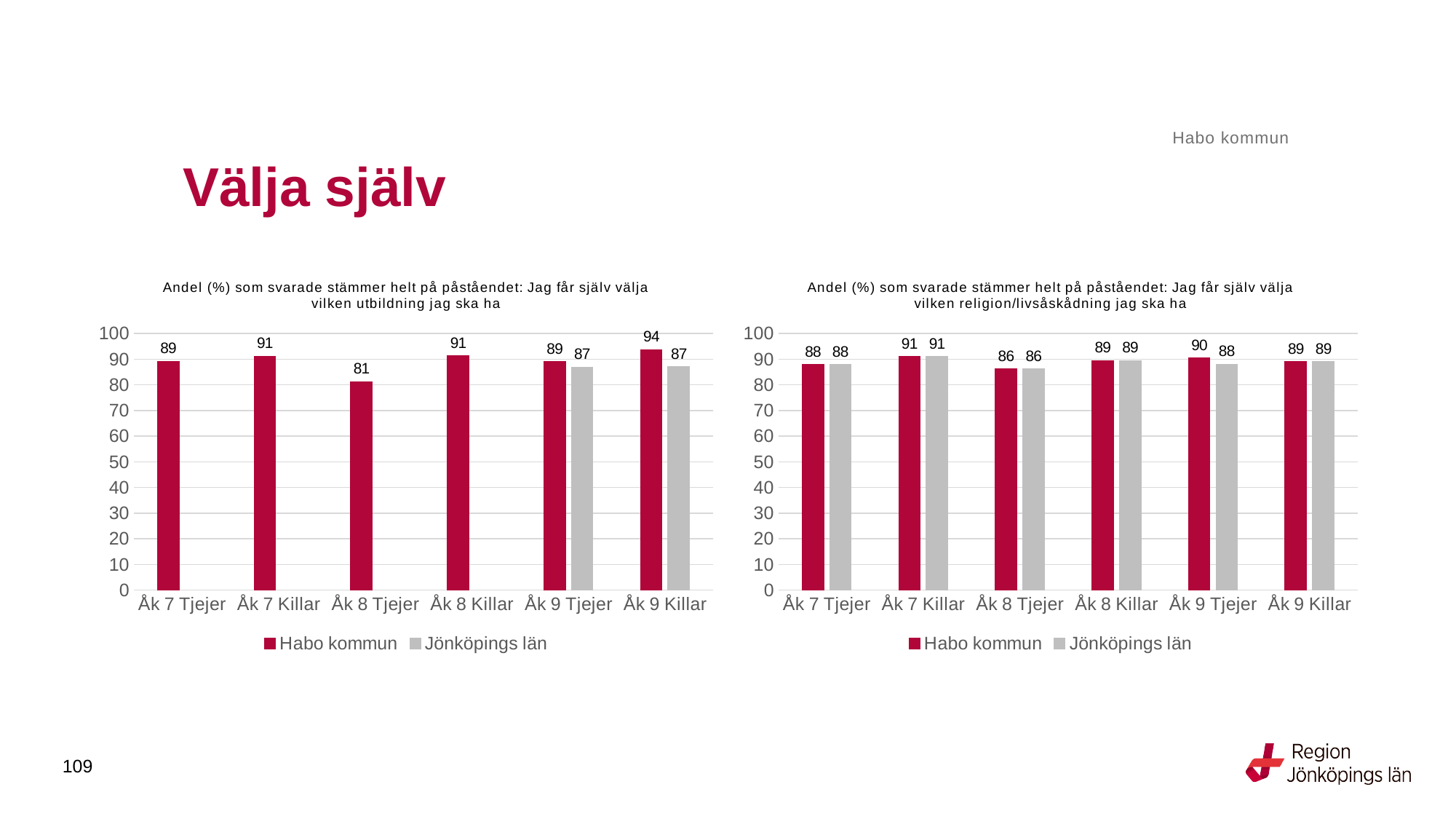
In the right chart (about choosing religion), what is the value for Habo kommun for Åk 9 Tjejer? 90 In the right chart (about choosing religion), which category has the highest Habo kommun value? Åk 7 Killar In the left chart (about choosing education), what is the difference between the Habo kommun values for Åk 9 Killar and Åk 8 Tjejer? 13 In the left chart (about choosing education), which category has the lowest Habo kommun value? Åk 8 Tjejer In the right chart (about choosing religion), what is the value for Jönköpings län for Åk 8 Tjejer? 86 In the left chart (about choosing education), what is the value for Habo kommun for Åk 8 Tjejer? 81 In the left chart (about choosing education), how many categories are shown on the x axis? 6 In the left chart (about choosing education), which category has the highest Habo kommun value? Åk 9 Killar In the right chart (about choosing religion), how many series does the legend list? 2 In the right chart (about choosing religion), what is the difference between the Habo kommun and Jönköpings län values for Åk 9 Tjejer? 2 What type of chart is the left chart? Bar chart In the left chart (about choosing education), what is the value for Jönköpings län for Åk 9 Killar? 87